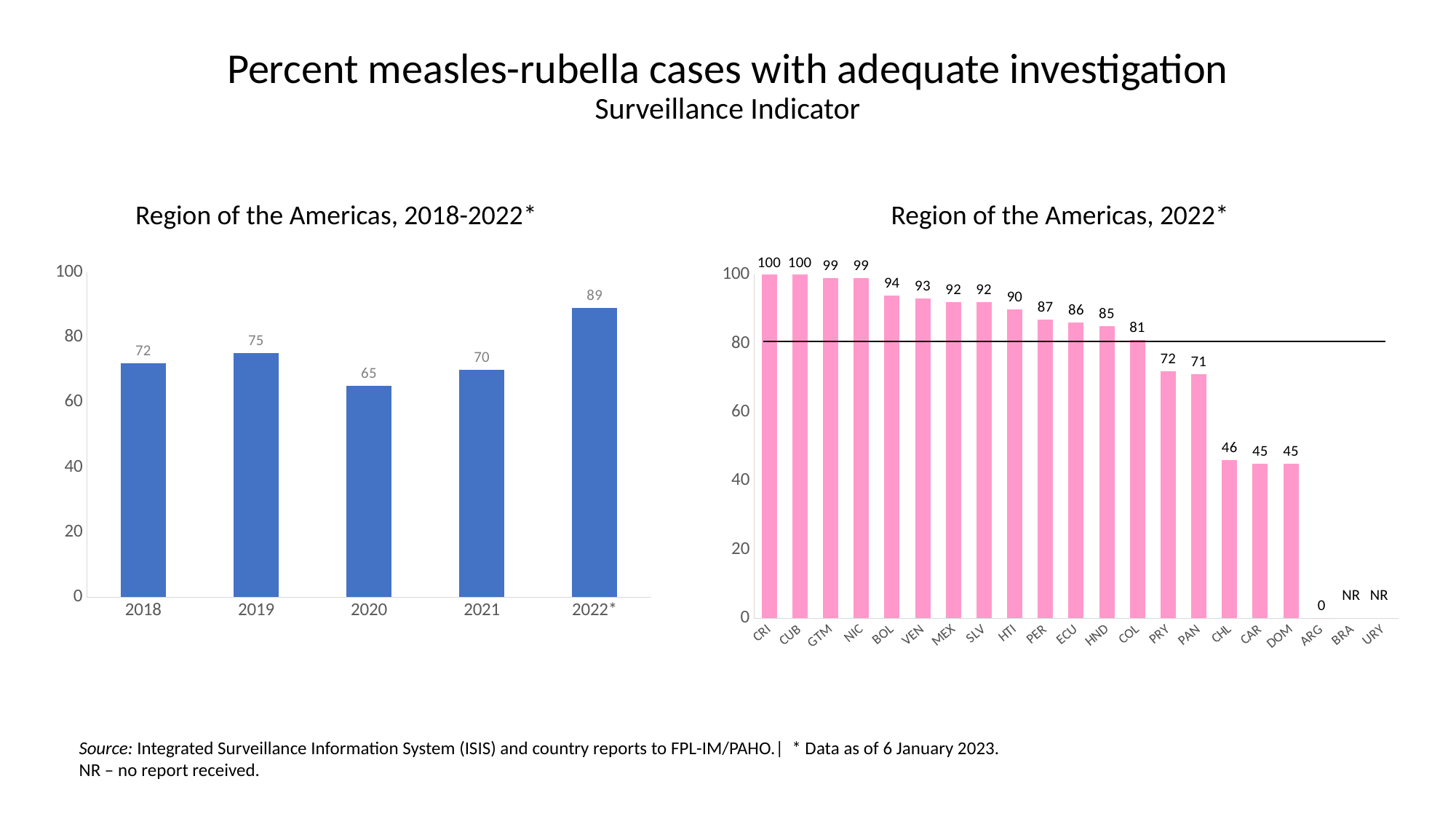
In the 'Region of the Americas, 2022*' chart, what is the difference between the values for COL and CHL? 35 In the 'Region of the Americas, 2018-2022*' chart, which year has the highest value? 2022* In the 'Region of the Americas, 2018-2022*' chart, which year has the lowest value? 2020 In the 'Region of the Americas, 2022*' chart, at what value is the horizontal reference line drawn? 80 In the 'Region of the Americas, 2018-2022*' chart, how many years are shown? 5 In the 'Region of the Americas, 2022*' chart, what is the value for PAN? 71 In the 'Region of the Americas, 2022*' chart, what is the value for HTI? 90 In the 'Region of the Americas, 2022*' chart, which is larger, the value for BOL or the value for ECU? BOL What type of chart is the 'Region of the Americas, 2022*' chart? Bar chart In the 'Region of the Americas, 2018-2022*' chart, what is the value for 2020? 65 In the 'Region of the Americas, 2022*' chart, how many countries are labelled NR? 2 In the 'Region of the Americas, 2018-2022*' chart, what is the difference between the values for 2022* and 2021? 19